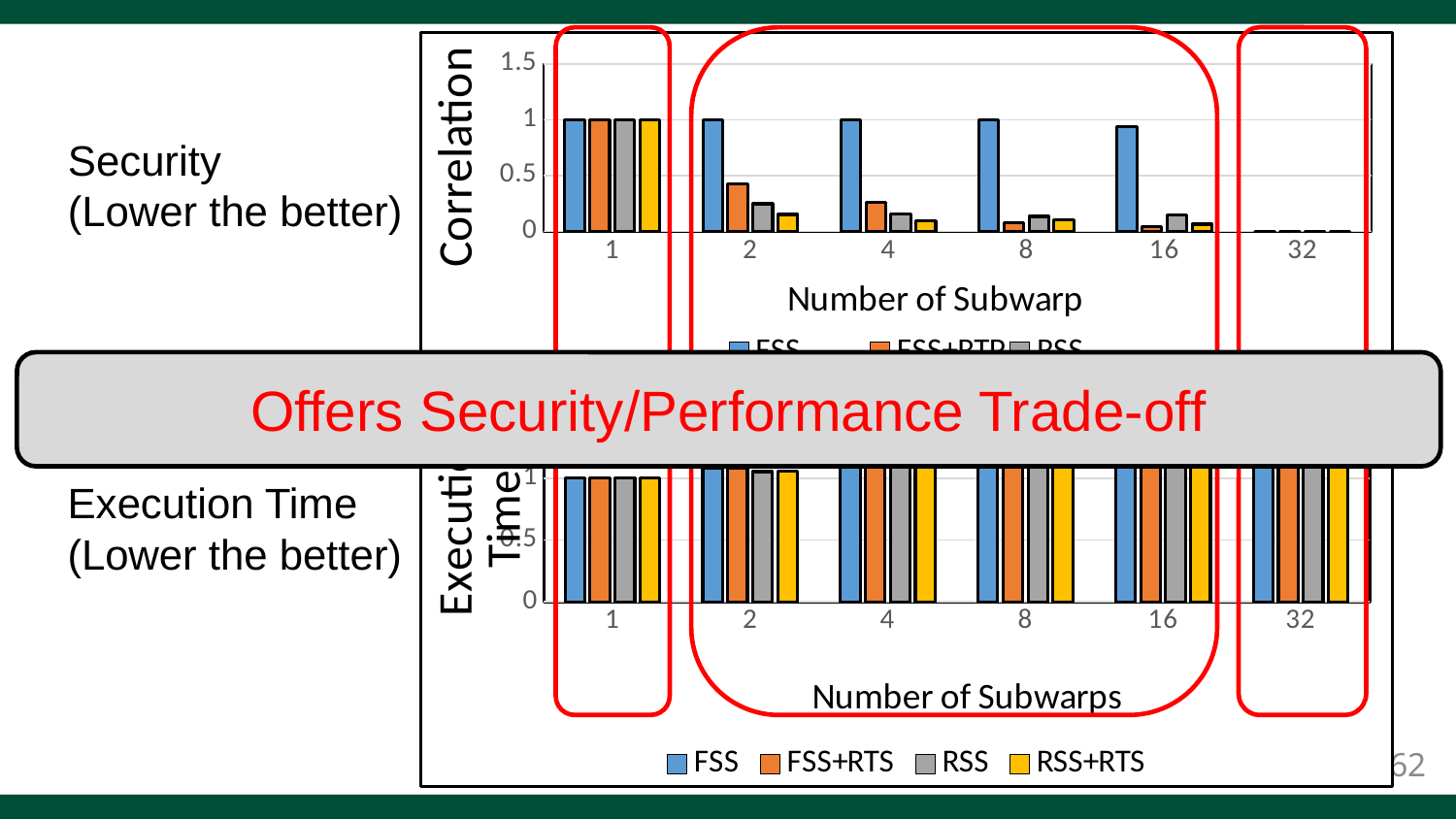
What is the x-axis title of the bottom Execution Time chart? Number of Subwarps How many series does the legend of the bottom Execution Time chart list? 4 In the top Correlation chart, is the FSS value at 2 subwarps greater or less than 0.5? greater In the top Correlation chart, which is larger at 4 subwarps: FSS or RSS? FSS In the top Correlation chart, is the FSS value at 16 subwarps greater or less than 0.5? greater In the top Correlation chart, which series has the highest value at 2 subwarps? FSS What kind of chart is the top chart (Correlation vs Number of Subwarp)? bar chart What is the y-axis title of the top chart? Correlation In the top Correlation chart, at which number of subwarps is the FSS correlation lowest? 32 How many categories are shown on the x axis of the top Correlation chart? 6